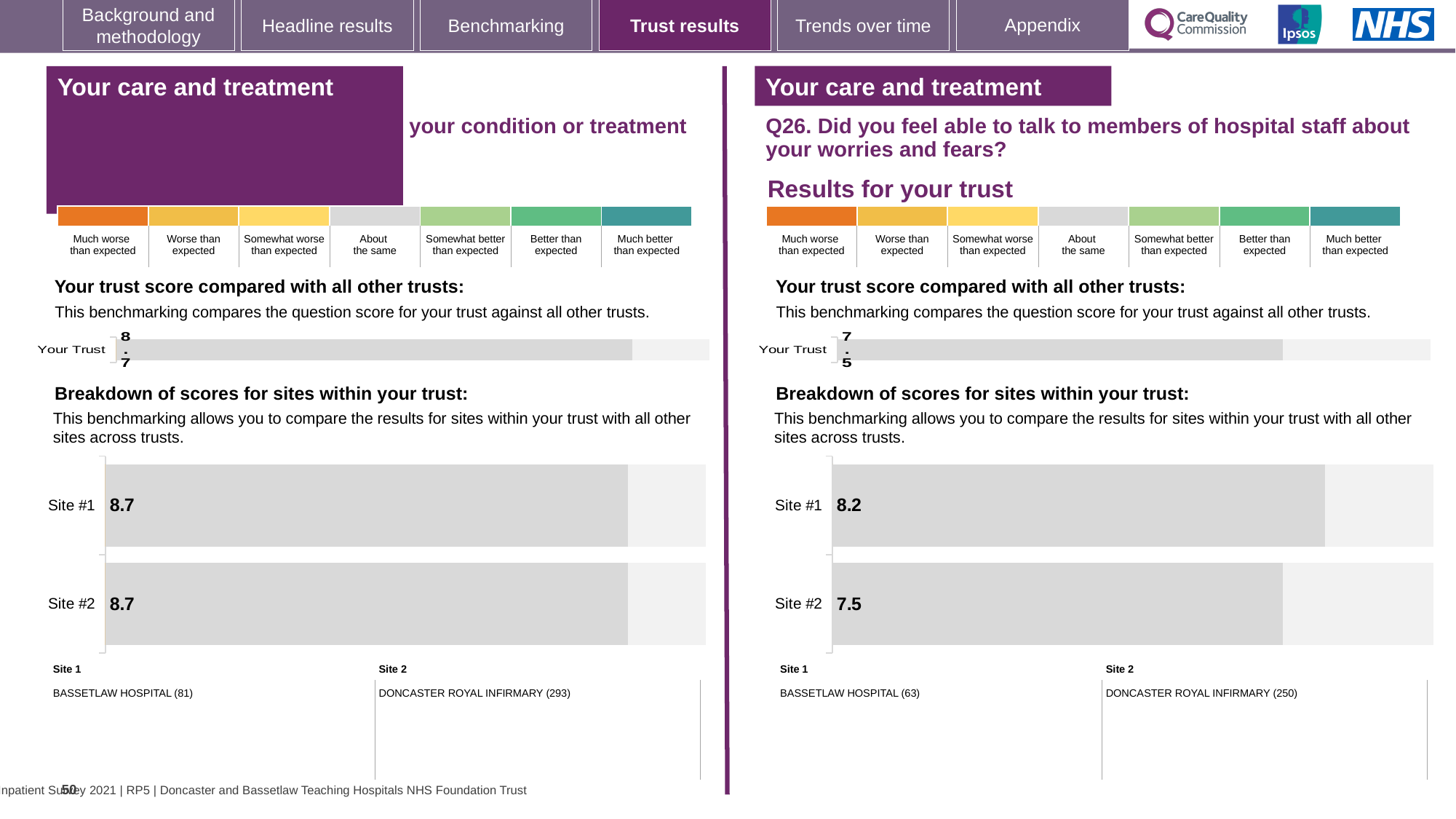
On the left half of the slide, what is the score shown for Your Trust in the 'Your trust score compared with all other trusts' chart? 8.7 In the Q26 site breakdown on the right, which hospital is listed as Site 2? DONCASTER ROYAL INFIRMARY (250) How many sites are shown in the Q26 site breakdown chart on the right? 2 On the right half of the slide (Q26), what is the score shown for Your Trust in the 'Your trust score compared with all other trusts' chart? 7.5 In the site breakdown chart on the left half of the slide, what is the score for Site #2? 8.7 In the Q26 'Breakdown of scores for sites within your trust' chart on the right, what is the score for Site #2? 7.5 In the Q26 'Breakdown of scores for sites within your trust' chart on the right, what is the score for Site #1? 8.2 In the site breakdown chart on the left half of the slide, what is the score for Site #1? 8.7 In the Q26 site breakdown chart on the right, which site has the higher score? Site #1 In the Q26 site breakdown chart on the right, what is the difference between the Site #1 and Site #2 scores? 0.7 What type of chart is used for the site breakdown on the right half of the slide? bar chart In the site breakdown chart on the left half of the slide, is the Site #1 score larger than, smaller than, or equal to the Site #2 score? equal